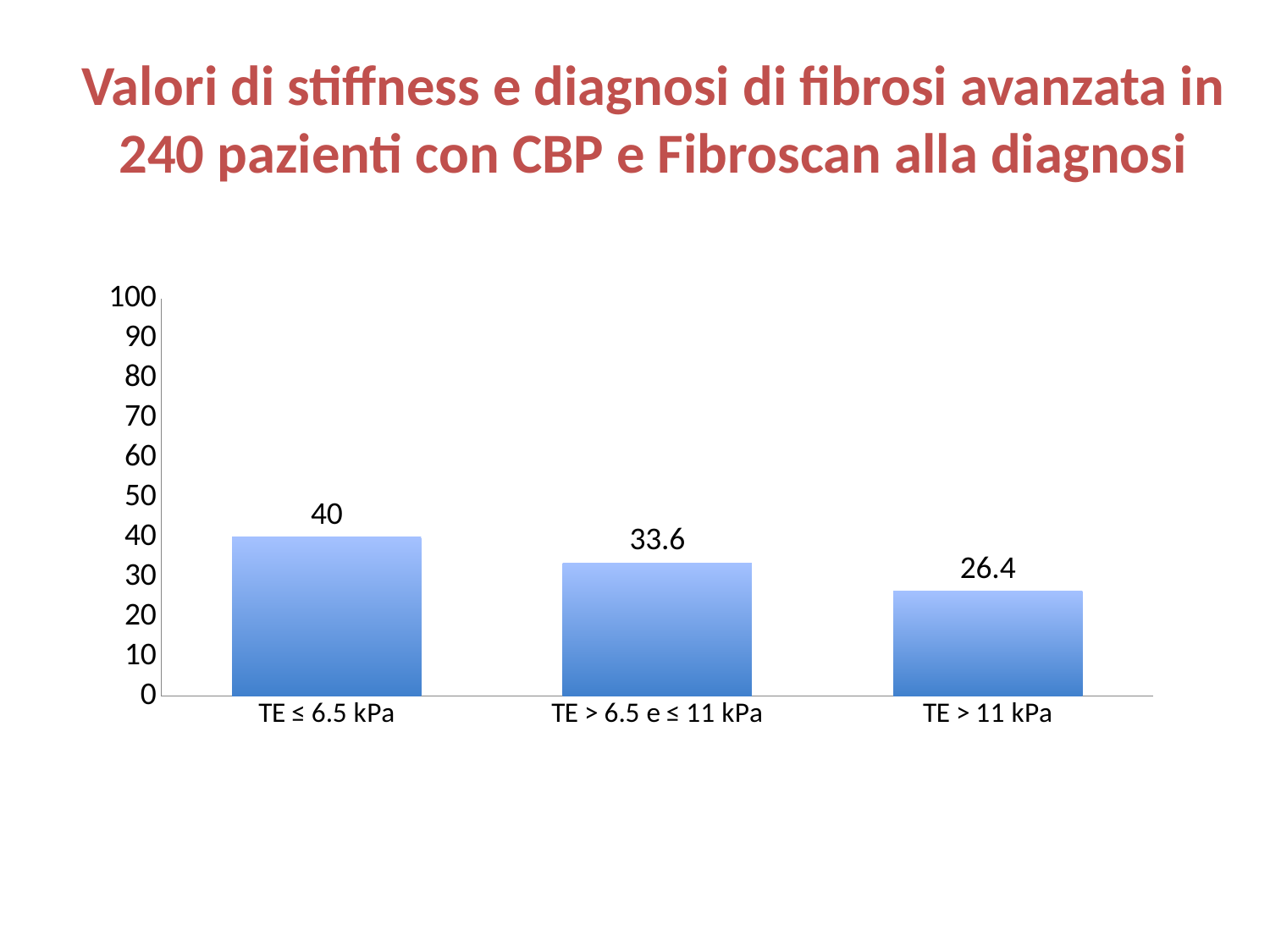
What kind of chart is shown on the slide? bar chart What is the value for TE > 6.5 e ≤ 11 kPa? 33.6 Do the values rise or fall from left to right along the x axis? fall Which category has the highest value? TE ≤ 6.5 kPa Which category has the lowest value? TE > 11 kPa What is the difference between the values for TE ≤ 6.5 kPa and TE > 11 kPa? 13.6 What is the value for TE > 11 kPa? 26.4 Which is larger, the value for TE > 6.5 e ≤ 11 kPa or the value for TE > 11 kPa? TE > 6.5 e ≤ 11 kPa What is the value for TE ≤ 6.5 kPa? 40 What is the difference between the values for TE ≤ 6.5 kPa and TE > 6.5 e ≤ 11 kPa? 6.4 How many categories are shown on the x axis? 3 Is the value for TE > 11 kPa greater or less than 30? less